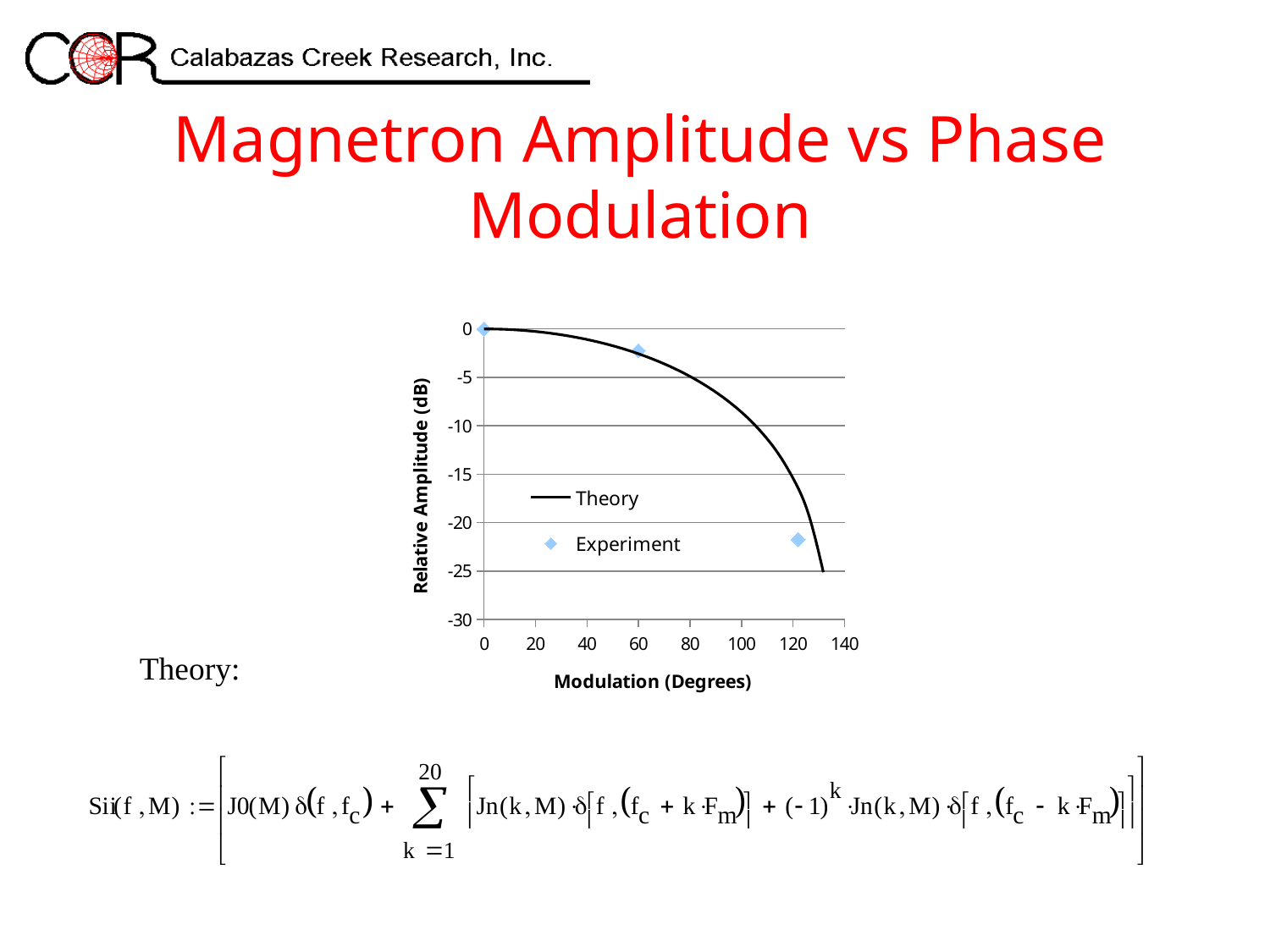
Is the Experiment value at about 60 degrees modulation greater or less than -5 dB? greater What is the lowest value shown on the Relative Amplitude (dB) axis? -30 Does the Theory curve rise or fall as Modulation (Degrees) increases? fall How many series does the chart legend list? 2 What are the two series named in the chart legend? Theory and Experiment How many Experiment data points are plotted on the chart? 3 Is the Experiment value at about 120 degrees modulation greater or less than -20 dB? less Is the Theory value at 100 degrees modulation greater or less than -15 dB? greater What is the title of the x axis of the chart? Modulation (Degrees) Which Experiment point has the lowest Relative Amplitude: the one at about 60 degrees or the one at about 120 degrees? the one at about 120 degrees What kind of chart is shown on the slide? line chart